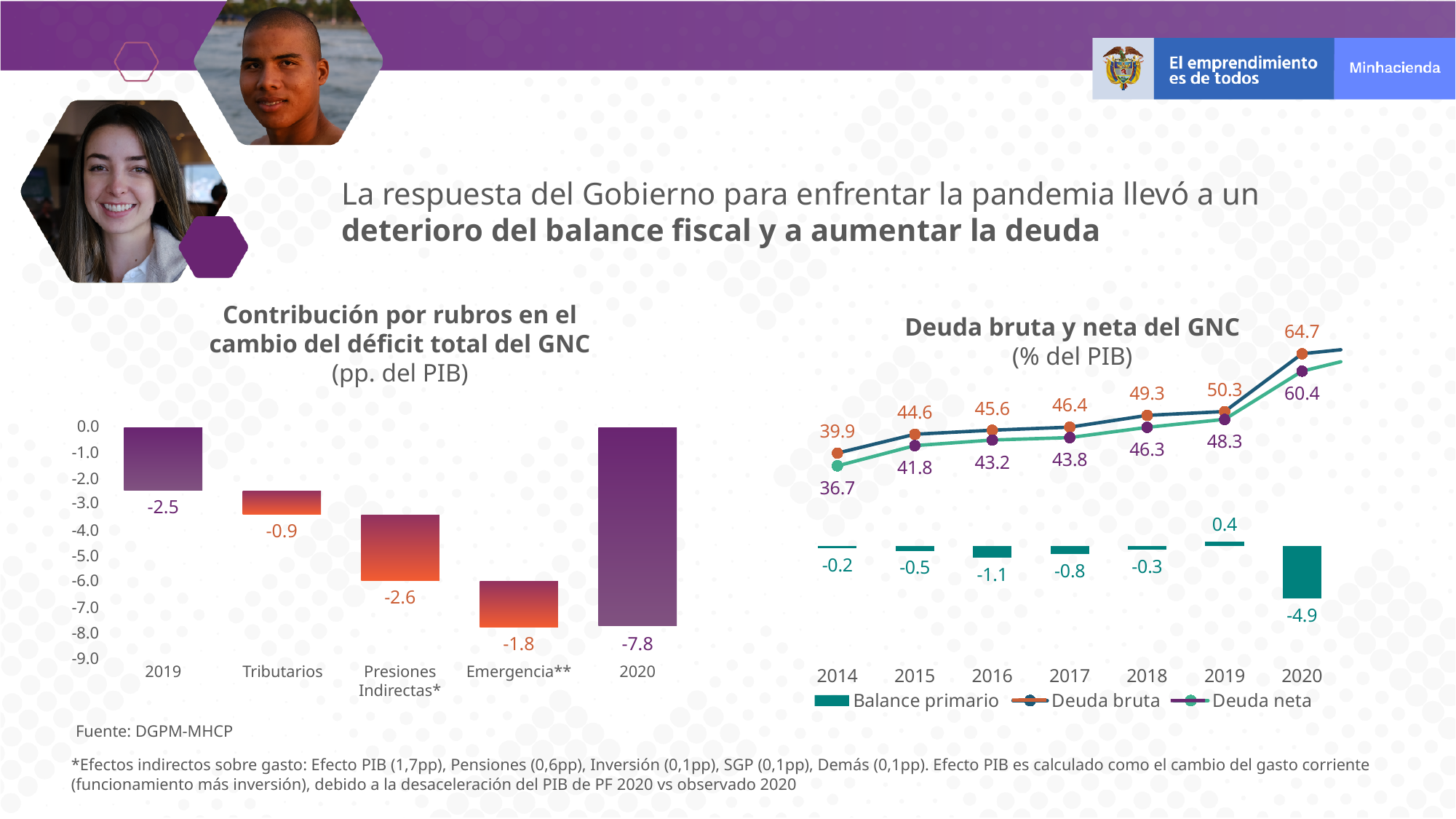
In the chart 'Deuda bruta y neta del GNC', what is the difference between Deuda bruta and Deuda neta in 2020? 4.3 In the chart 'Deuda bruta y neta del GNC', what is the Balance primario value for 2019? 0.4 In the chart 'Deuda bruta y neta del GNC', does Deuda bruta rise or fall from 2014 to 2020? Rises In the chart 'Deuda bruta y neta del GNC', which year has the lowest Balance primario value? 2020 In the chart 'Contribución por rubros en el cambio del déficit total del GNC', how many categories are shown on the x axis? 5 In the chart 'Contribución por rubros en el cambio del déficit total del GNC', which category has the lowest value? 2020 In the chart 'Deuda bruta y neta del GNC', what is the Deuda bruta value for 2020? 64.7 In the chart 'Contribución por rubros en el cambio del déficit total del GNC', what is the value for Tributarios? -0.9 In the chart 'Contribución por rubros en el cambio del déficit total del GNC', what is the value for 2020? -7.8 What kind of chart is 'Contribución por rubros en el cambio del déficit total del GNC'? Bar chart How many series does the legend of the chart 'Deuda bruta y neta del GNC' list? 3 In the chart 'Deuda bruta y neta del GNC', what is the Deuda neta value for 2014? 36.7